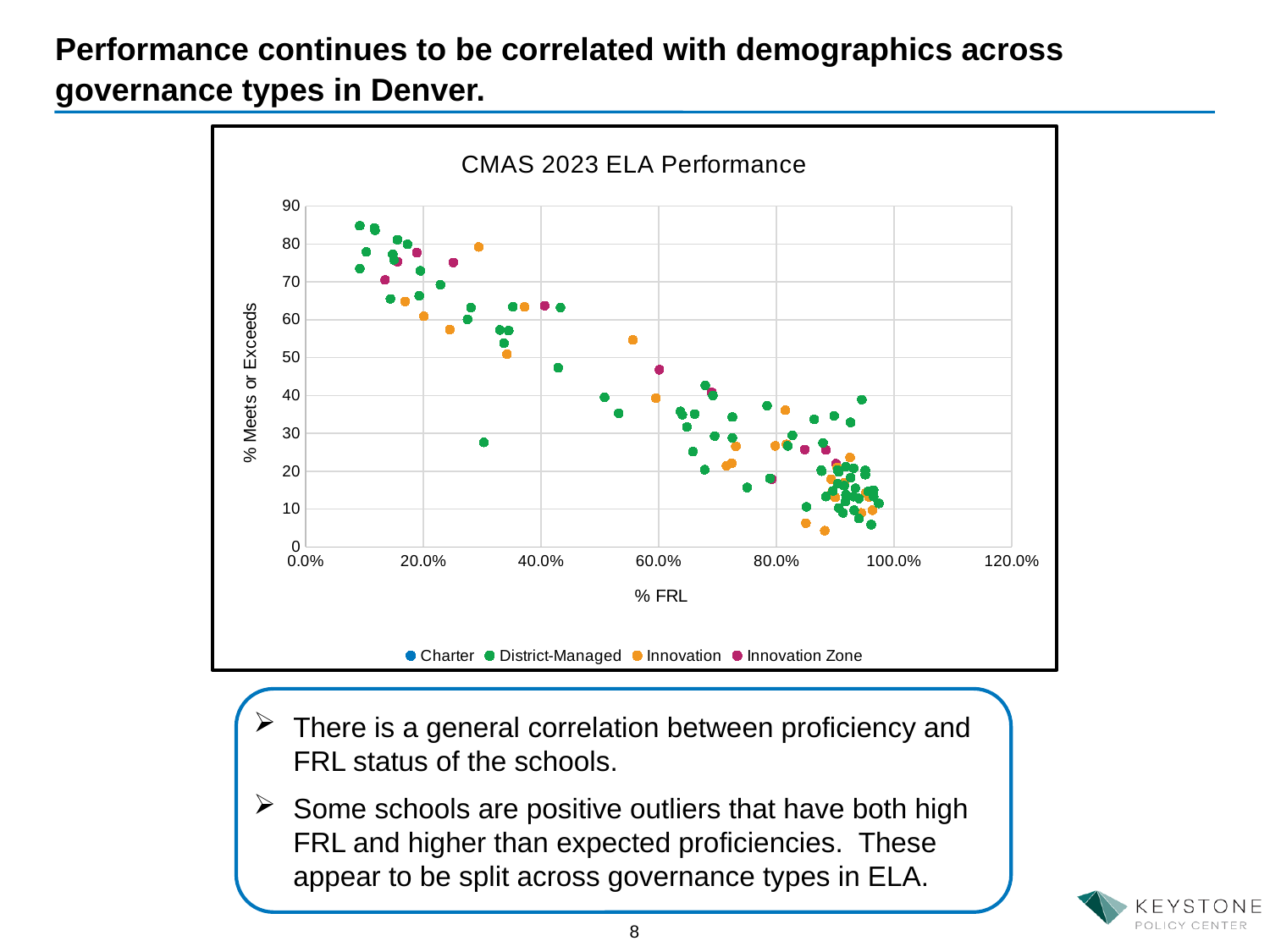
What label is shown on the x axis of the chart? % FRL What kind of chart is shown on the slide? scatter chart As % FRL increases along the x axis, do the % Meets or Exceeds values generally rise or fall? fall How many series does the legend of the chart list? 4 What is the title of the chart? CMAS 2023 ELA Performance